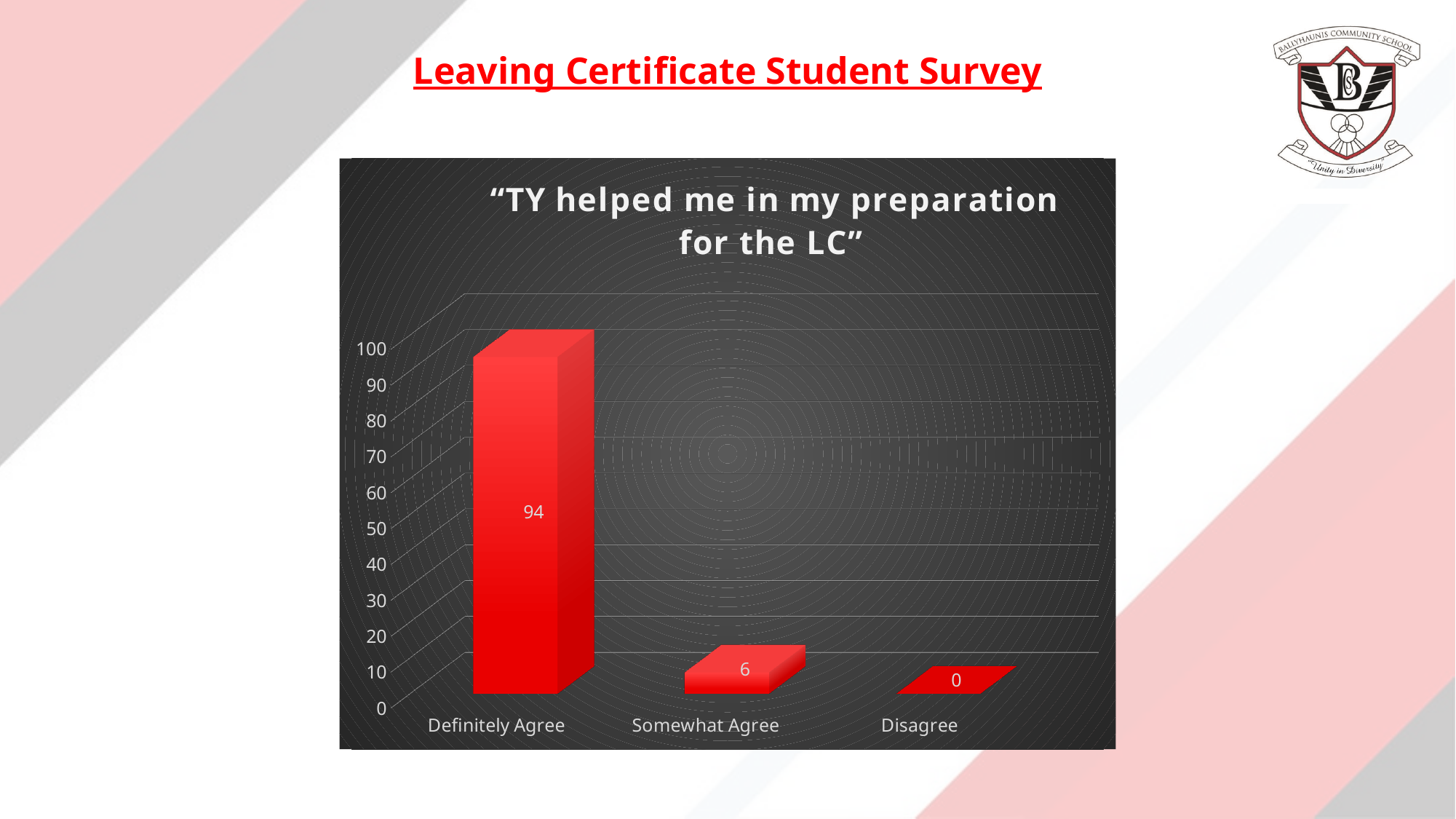
Which is larger, the value for Somewhat Agree or the value for Disagree? Somewhat Agree Do the values rise or fall from left to right along the x axis? fall How many categories are shown on the x axis? 3 Which category has the highest value? Definitely Agree What is the value for Definitely Agree? 94 Is the value for Definitely Agree greater or less than 50? greater Which category has the lowest value? Disagree What is the title of the chart? "TY helped me in my preparation for the LC" What is the value for Somewhat Agree? 6 What kind of chart is shown on the slide? bar chart What is the value for Disagree? 0 What is the difference between the values for Definitely Agree and Somewhat Agree? 88